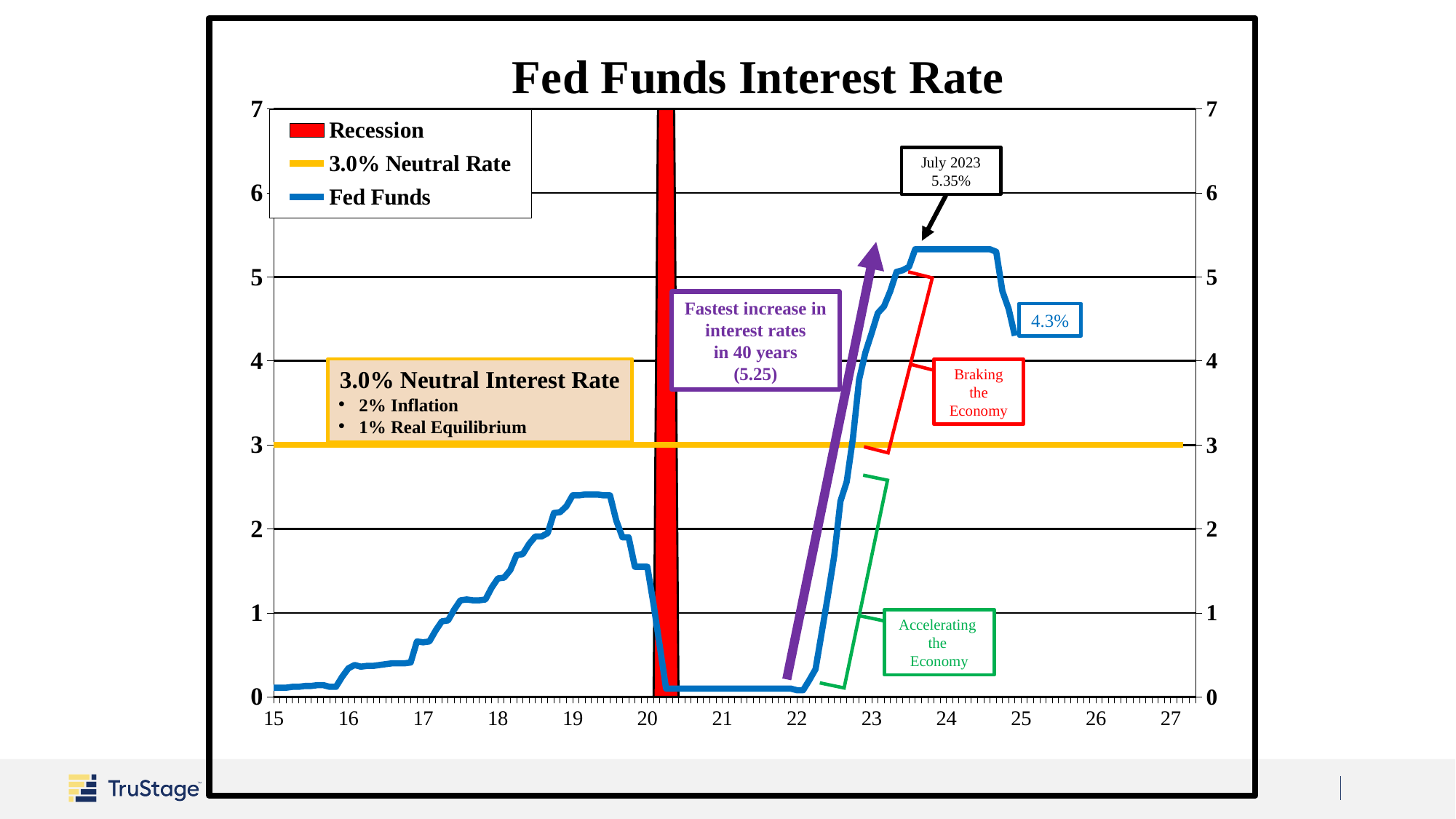
Is the Fed Funds rate at the start of 2024 greater or less than 5? greater What value is labeled at the end of the Fed Funds line, around 2025? 4.3% Is the Fed Funds rate in 2021 greater or less than 1? less What kind of chart is shown on the slide? line chart What is the difference between the July 2023 rate of 5.35% and the later labeled rate of 4.3%? 1.05% What is the neutral interest rate shown by the yellow horizontal line? 3.0% What Fed Funds rate is labeled for July 2023? 5.35% What does the red vertical bar on the chart represent? Recession How many entries does the chart's legend list? 3 Does the Fed Funds rate rise or fall between 2022 and 2023? rise Which is higher, the Fed Funds rate in 2019 or in 2024? 2024 What is the title of the chart? Fed Funds Interest Rate